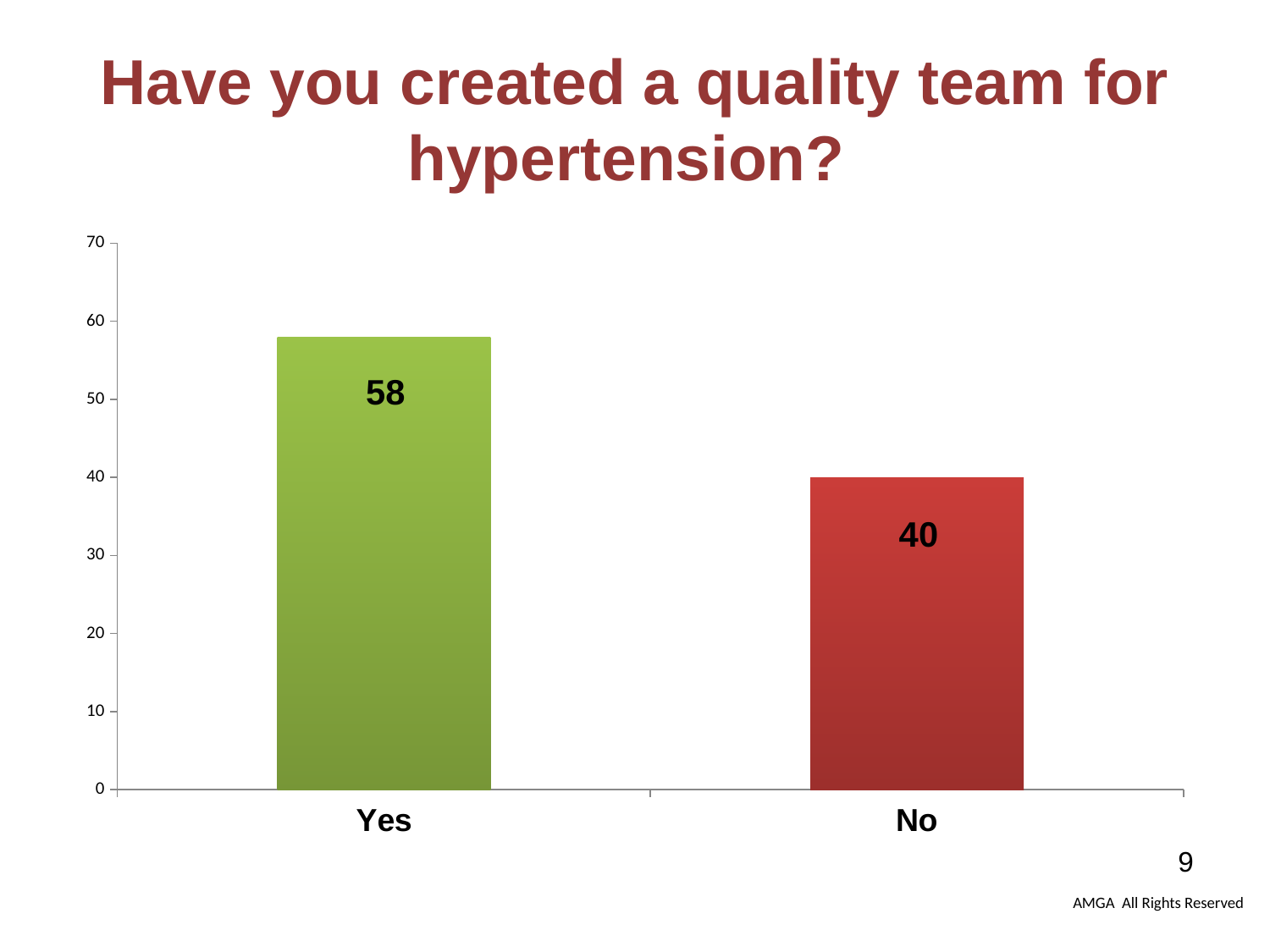
Which category has the lowest value? No Which category has the highest value? Yes Is the value for Yes greater or less than 50? greater Which is larger, the value for Yes or the value for No? Yes What is the title of the slide? Have you created a quality team for hypertension? Is the value for No greater or less than 50? less What kind of chart is shown on the slide? bar chart What is the value for No? 40 What is the value for Yes? 58 How many categories are shown on the x axis? 2 What colour is the bar for No? red What is the difference between the values for Yes and No? 18